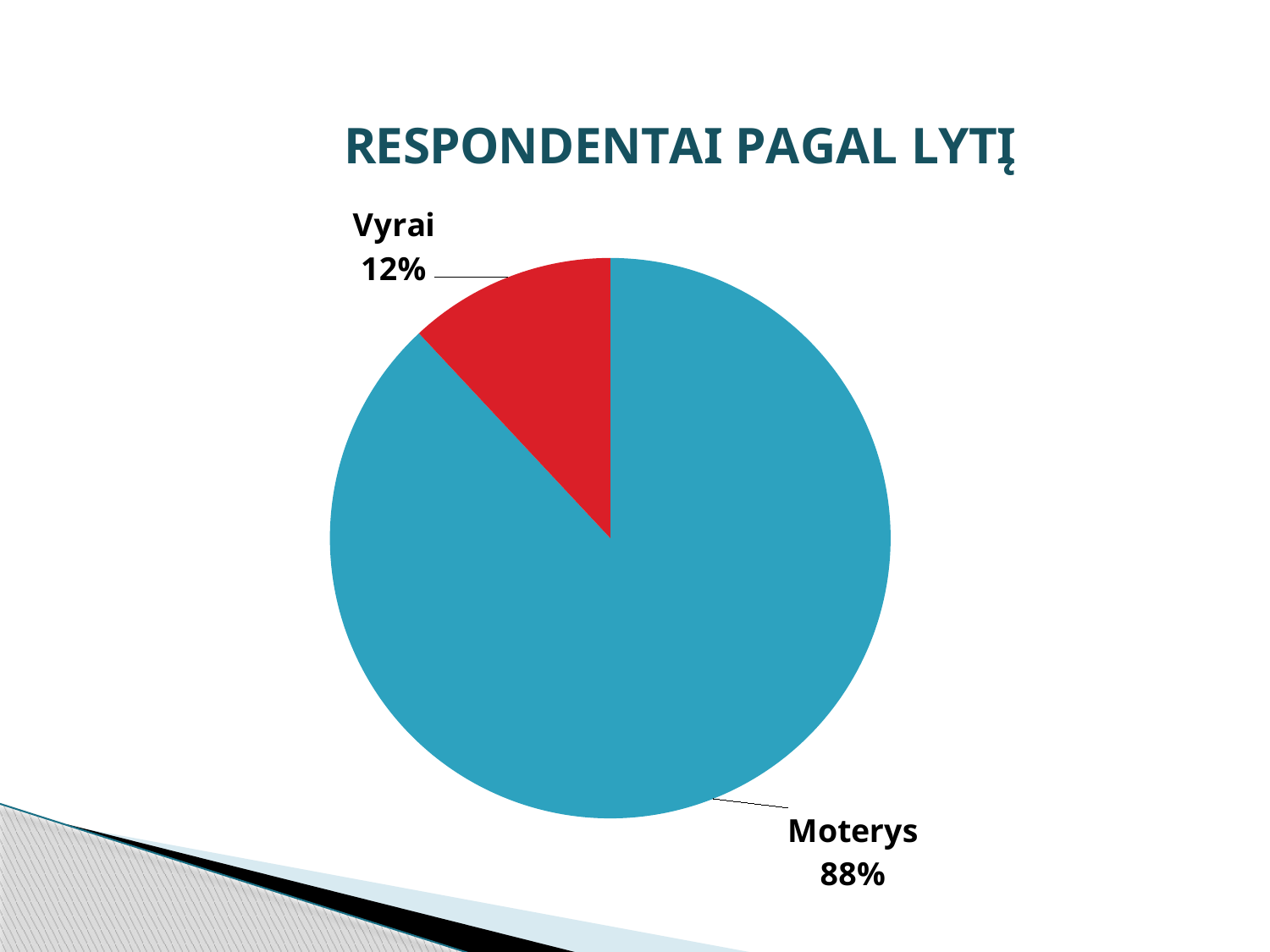
What colour is the Vyrai slice? red What is the difference in percentage points between Moterys and Vyrai? 76 Which is larger, the share for Vyrai or the share for Moterys? Moterys What percentage of respondents are Vyrai? 12% What is the title of the chart? RESPONDENTAI PAGAL LYTĮ How many slices does the pie chart have? 2 What kind of chart is shown on the slide? pie chart What percentage of respondents are Moterys? 88% What share of the pie does the Vyrai slice represent? 12% Which category has the largest share of the pie? Moterys Which category has the smallest share of the pie? Vyrai